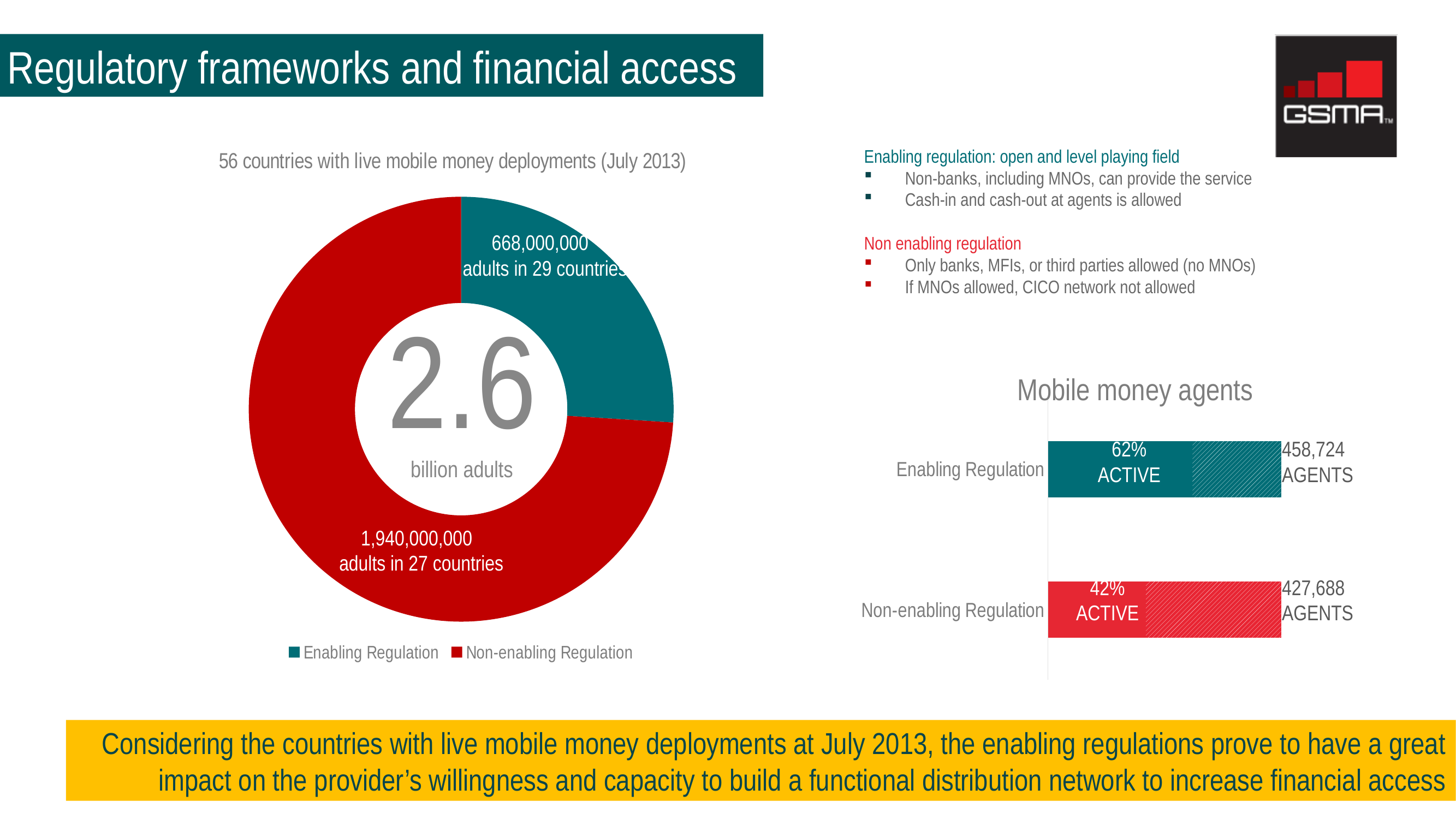
In the "Mobile money agents" chart, what percentage of agents are active under Non-enabling Regulation? 42% In the doughnut chart on the left, what is the difference in adults between Non-enabling Regulation and Enabling Regulation? 1,272,000,000 What kind of chart is the one titled "Mobile money agents"? Bar chart In the doughnut chart on the left, how many adults are in countries with Enabling Regulation? 668,000,000 In the doughnut chart on the left, how many countries fall under Non-enabling Regulation? 27 In the "Mobile money agents" chart, how many agents are there under Enabling Regulation? 458,724 In the doughnut chart on the left, how many adults are in countries with Non-enabling Regulation? 1,940,000,000 In the doughnut chart on the left, what total number of adults is shown in the centre? 2.6 billion adults In the "Mobile money agents" chart, what is the difference in the number of agents between Enabling Regulation and Non-enabling Regulation? 31,036 In the doughnut chart on the left, which segment is larger, Enabling Regulation or Non-enabling Regulation? Non-enabling Regulation How many entries does the legend of the doughnut chart on the left list? 2 What kind of chart is the one titled "56 countries with live mobile money deployments (July 2013)"? Doughnut (pie) chart